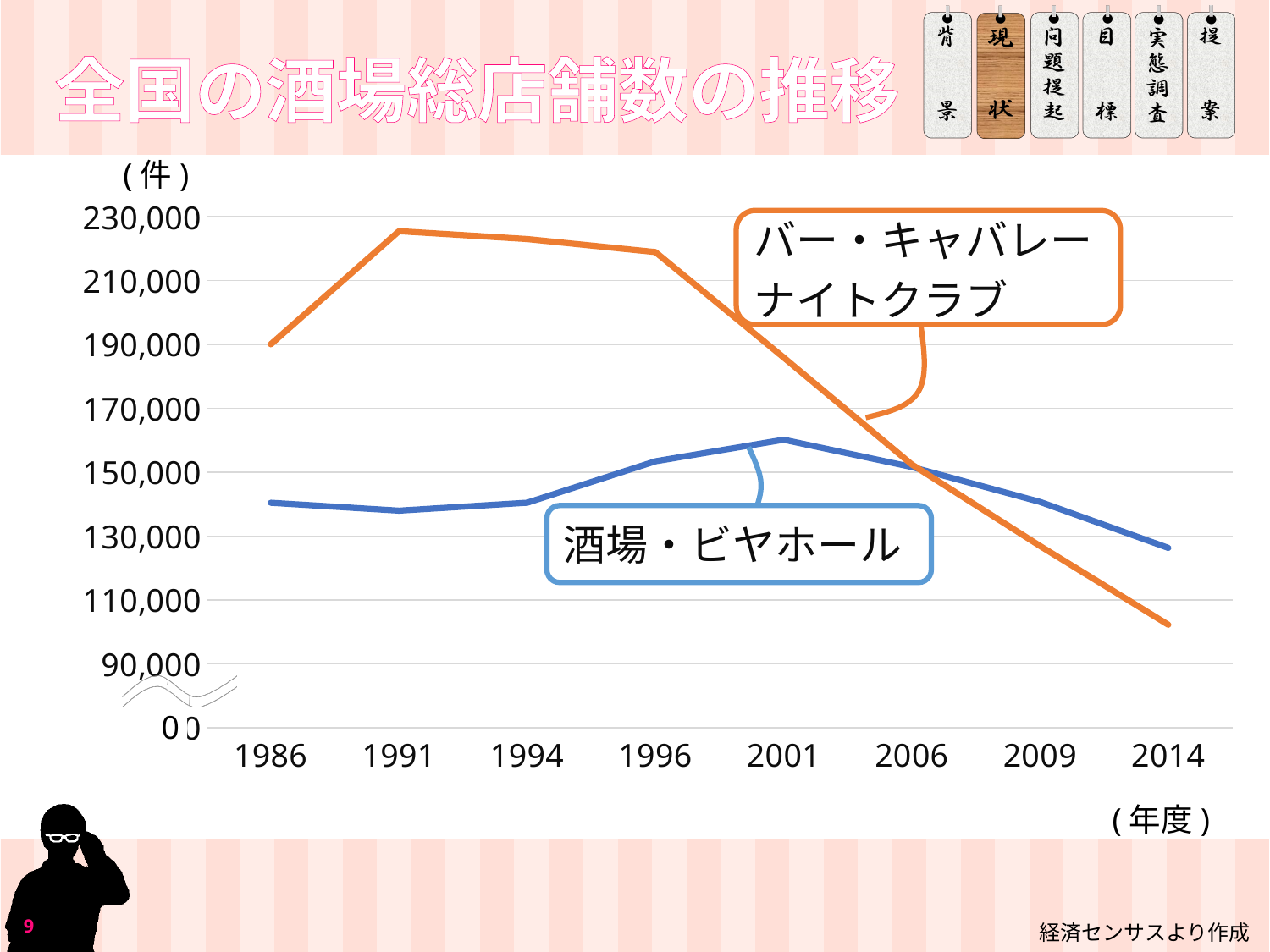
In which year does the バー・キャバレー・ナイトクラブ series reach its lowest value? 2014 How many series are plotted in the chart? 2 What kind of chart is shown on the slide? line chart In which year does the 酒場・ビヤホール series reach its highest value? 2001 In 1996, which series has the higher value, バー・キャバレー・ナイトクラブ or 酒場・ビヤホール? バー・キャバレー・ナイトクラブ Is the value for バー・キャバレー・ナイトクラブ in 2014 greater or less than 110,000? less In which year does the バー・キャバレー・ナイトクラブ series reach its highest value? 1991 How many years are shown on the x axis of the chart? 8 Does the バー・キャバレー・ナイトクラブ series rise or fall from 1996 to 2014? fall Is the value for バー・キャバレー・ナイトクラブ in 1991 greater or less than 210,000? greater In 2014, which series has the higher value, バー・キャバレー・ナイトクラブ or 酒場・ビヤホール? 酒場・ビヤホール Is the value for 酒場・ビヤホール in 2001 greater or less than 150,000? greater